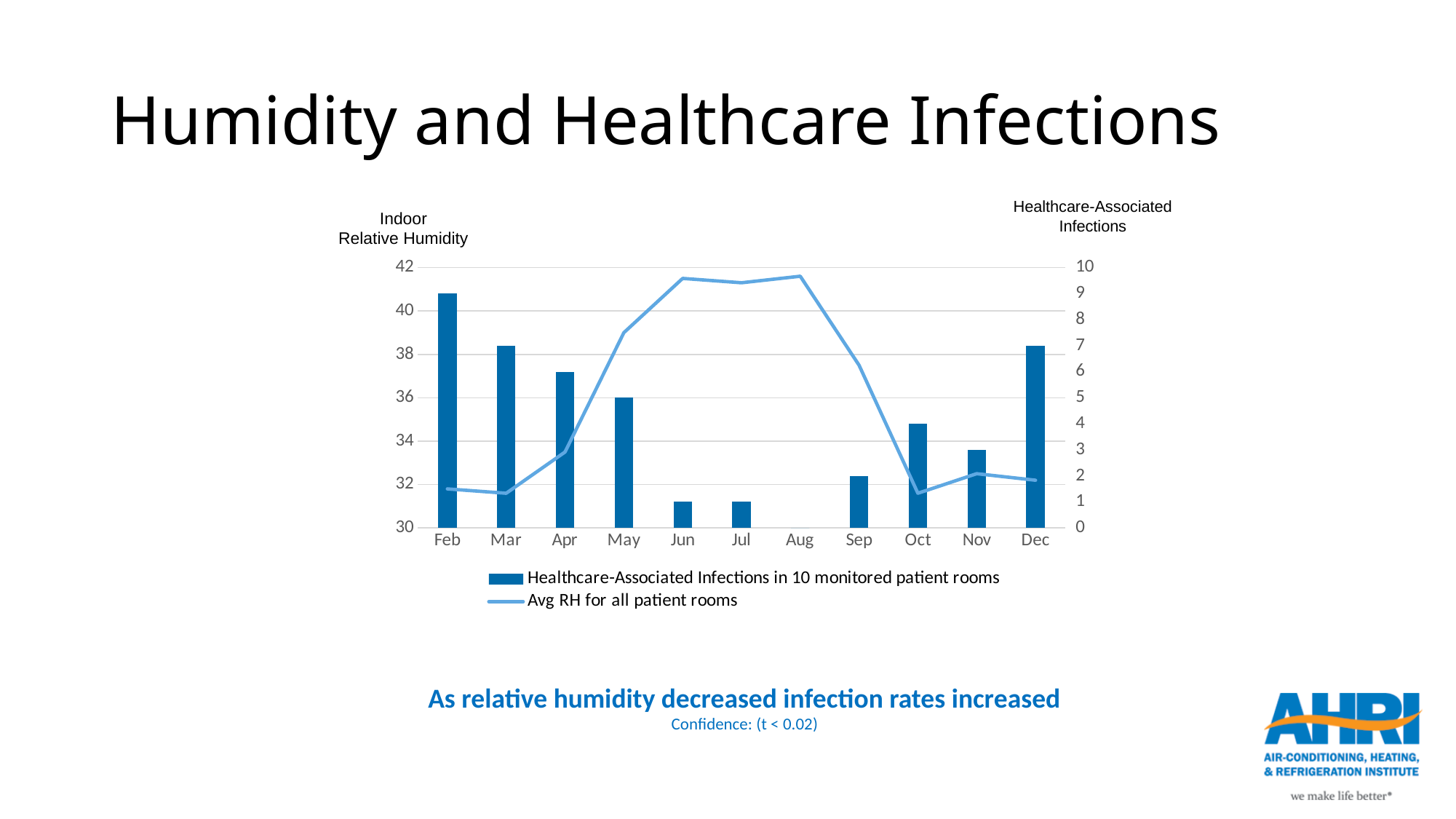
How many months are shown on the x axis? 11 Is the Avg RH value for Jun greater or less than 40? greater Which month has the larger Healthcare-Associated Infections bar, Mar or Oct? Mar What is the label on the left vertical axis? Indoor Relative Humidity Which month has the tallest Healthcare-Associated Infections bar? Feb Is the Avg RH value for Feb greater or less than 34? less Is the Healthcare-Associated Infections value for Jun greater or less than 2? less Do the Healthcare-Associated Infections bars rise or fall from Feb to Jun? fall Which month shows no Healthcare-Associated Infections bar at all? Aug How many series does the legend list? 2 What kind of chart is shown on the slide? A combination bar and line chart